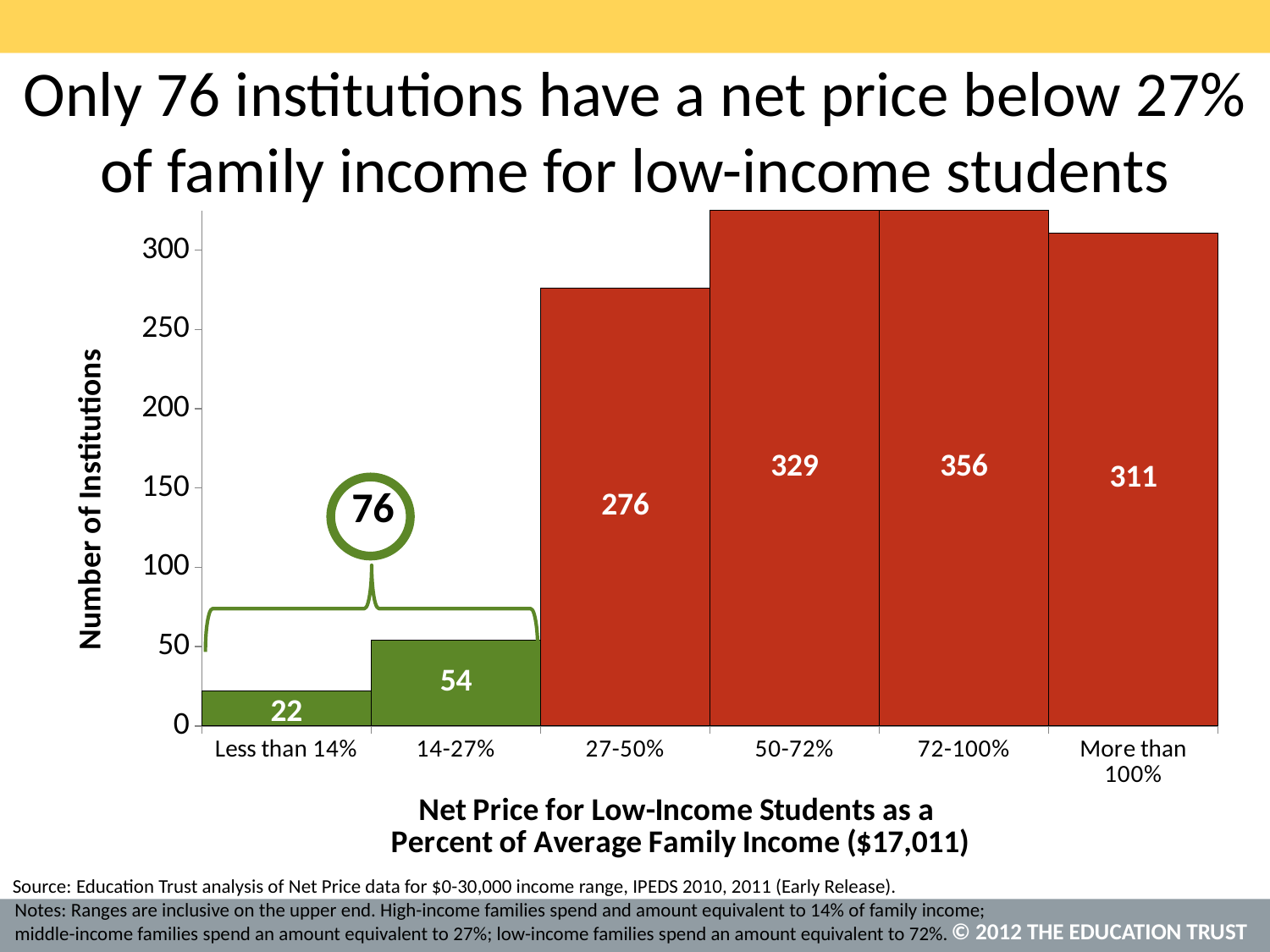
Which category has the highest number of institutions? 72-100% What is the combined total of the two green bars (Less than 14% and 14-27%)? 76 How many institutions have a net price of less than 14% of average family income? 22 What is the number of institutions in the 14-27% category? 54 How many institutions fall in the 'More than 100%' category? 311 Is the value for 27-50% greater or less than 250? greater Which is larger, the value for 50-72% or the value for More than 100%? 50-72% What is the value for the 72-100% category? 356 What kind of chart is shown on the slide? Bar chart Which category has the lowest number of institutions? Less than 14% How many categories are shown on the x axis? 6 What is the difference between the 50-72% and 27-50% categories? 53